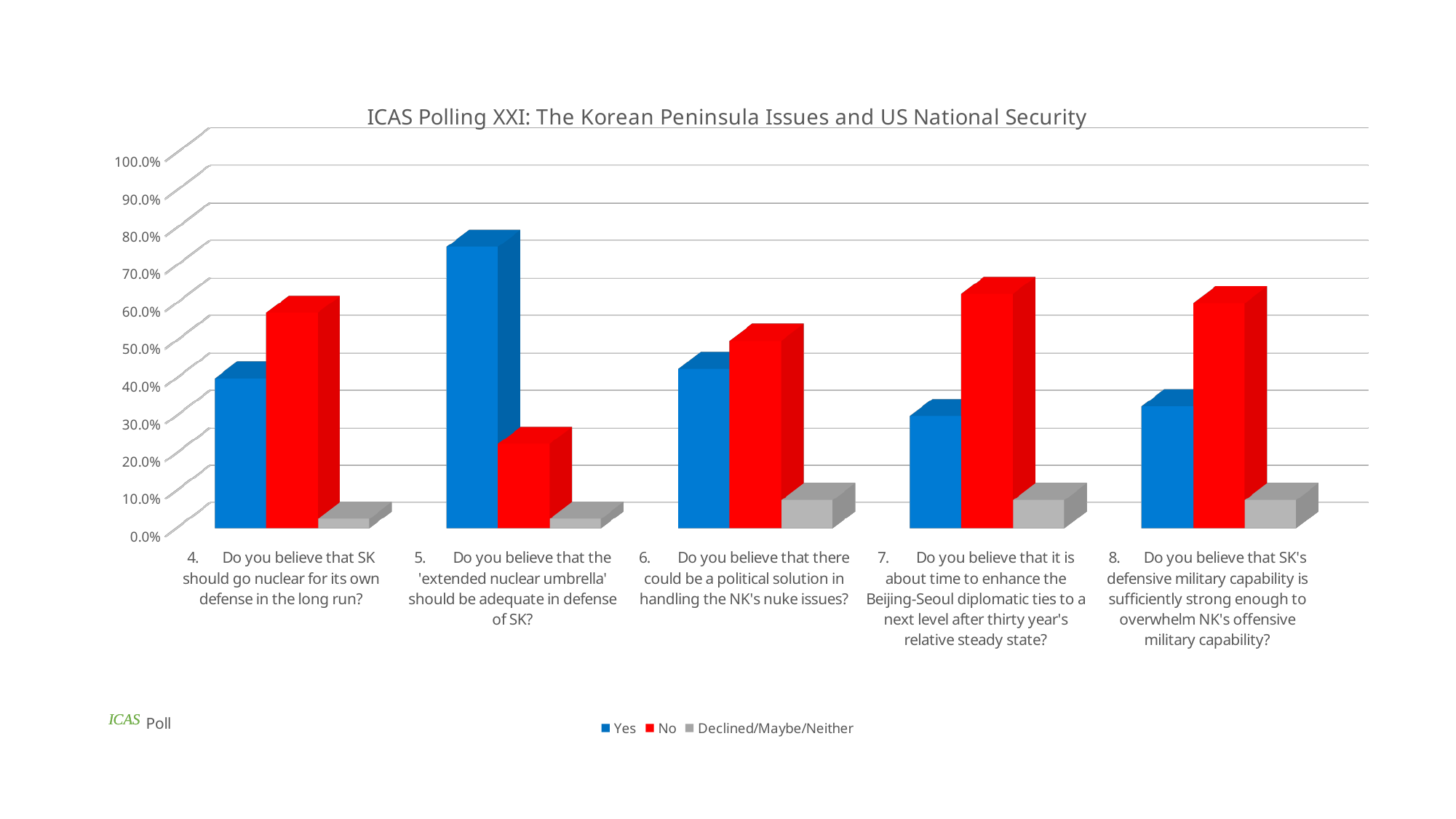
For which question is the 'Yes' bar the lowest? 7. Do you believe that it is about time to enhance the Beijing-Seoul diplomatic ties to a next level after thirty year's relative steady state? Is the 'No' value for question 5 (extended nuclear umbrella) greater or less than 30.0%? less What kind of chart is shown on the slide? Bar chart For question 4 (SK should go nuclear), which is larger, the 'Yes' bar or the 'No' bar? No For question 5 (extended nuclear umbrella), which is larger, the 'Yes' bar or the 'No' bar? Yes How many series does the legend list? 3 Is the 'Yes' value for question 5 (extended nuclear umbrella) greater or less than 70.0%? greater What is the title of the chart? ICAS Polling XXI: The Korean Peninsula Issues and US National Security Which colour represents the 'No' series in the legend? Red How many poll questions (categories) are plotted on the x axis? 5 For which question is the 'Yes' bar the highest? 5. Do you believe that the 'extended nuclear umbrella' should be adequate in defense of SK?